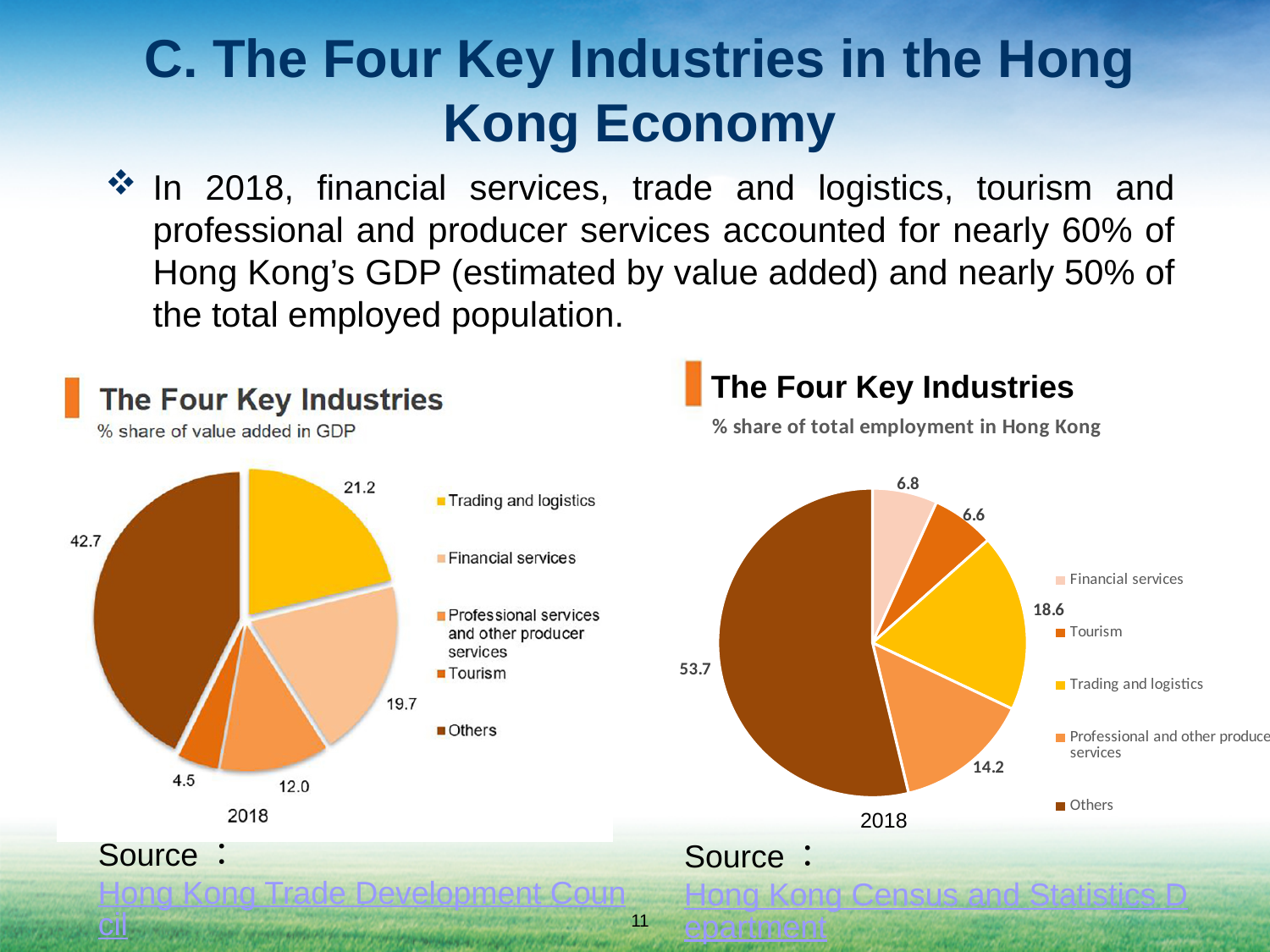
In the left chart (% share of value added in GDP), what is the share for Trading and logistics? 21.2 In the left chart (% share of value added in GDP), which category has the largest share? Others In the right chart (% share of total employment in Hong Kong), what is the share for Others? 53.7 In the left chart (% share of value added in GDP), which category has the smallest share? Tourism In the right chart (% share of total employment in Hong Kong), which is larger, Financial services or Professional and other producer services? Professional and other producer services How many categories does the legend of the right chart (% share of total employment in Hong Kong) list? 5 In the right chart (% share of total employment in Hong Kong), what is the difference between Trading and logistics and Professional and other producer services? 4.4 Which year is shown beneath both pie charts? 2018 In the left chart (% share of value added in GDP), what is the difference between Financial services and Professional services and other producer services? 7.7 What type of chart is the left chart (% share of value added in GDP)? Pie chart In the right chart (% share of total employment in Hong Kong), what is the share for Trading and logistics? 18.6 In the left chart (% share of value added in GDP), what is the share for Tourism? 4.5